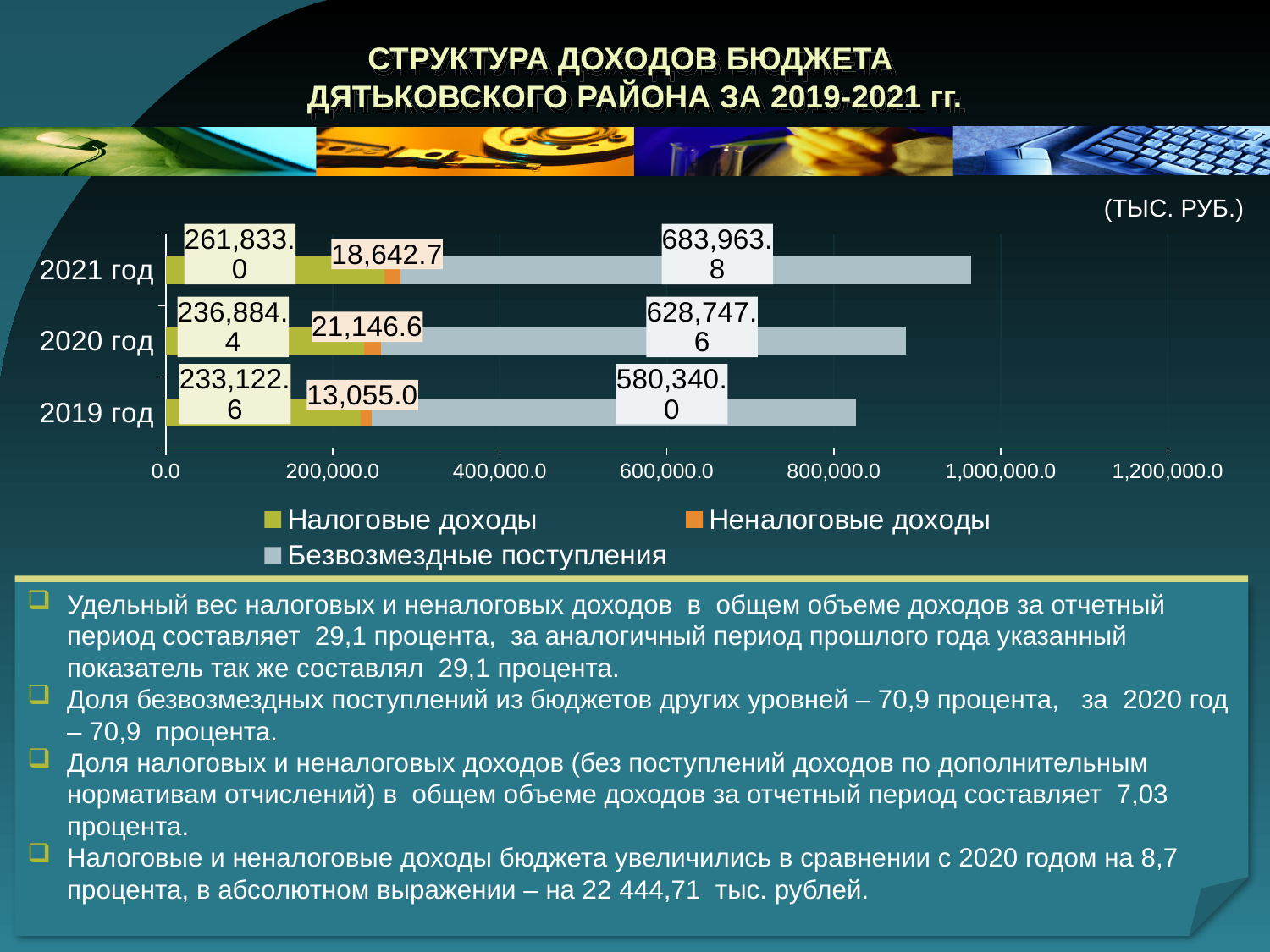
Which is larger: Налоговые доходы in 2020 год or in 2019 год? 2020 год Which year has the lowest value of Неналоговые доходы? 2019 год What is the value of Налоговые доходы for 2021 год? 261,833.0 What is the value of Безвозмездные поступления for 2019 год? 580,340.0 Which year has the highest value of Безвозмездные поступления? 2021 год What type of chart is shown on the slide? stacked bar chart Do the values of Налоговые доходы rise or fall from 2019 год to 2021 год? rise What is the total of the stacked bar for 2021 год? 964,439.5 What is the value of Неналоговые доходы for 2020 год? 21,146.6 How many series does the chart legend list? 3 What is the difference between Безвозмездные поступления in 2021 год and 2020 год? 55,216.2 How many years (categories) are shown on the chart? 3